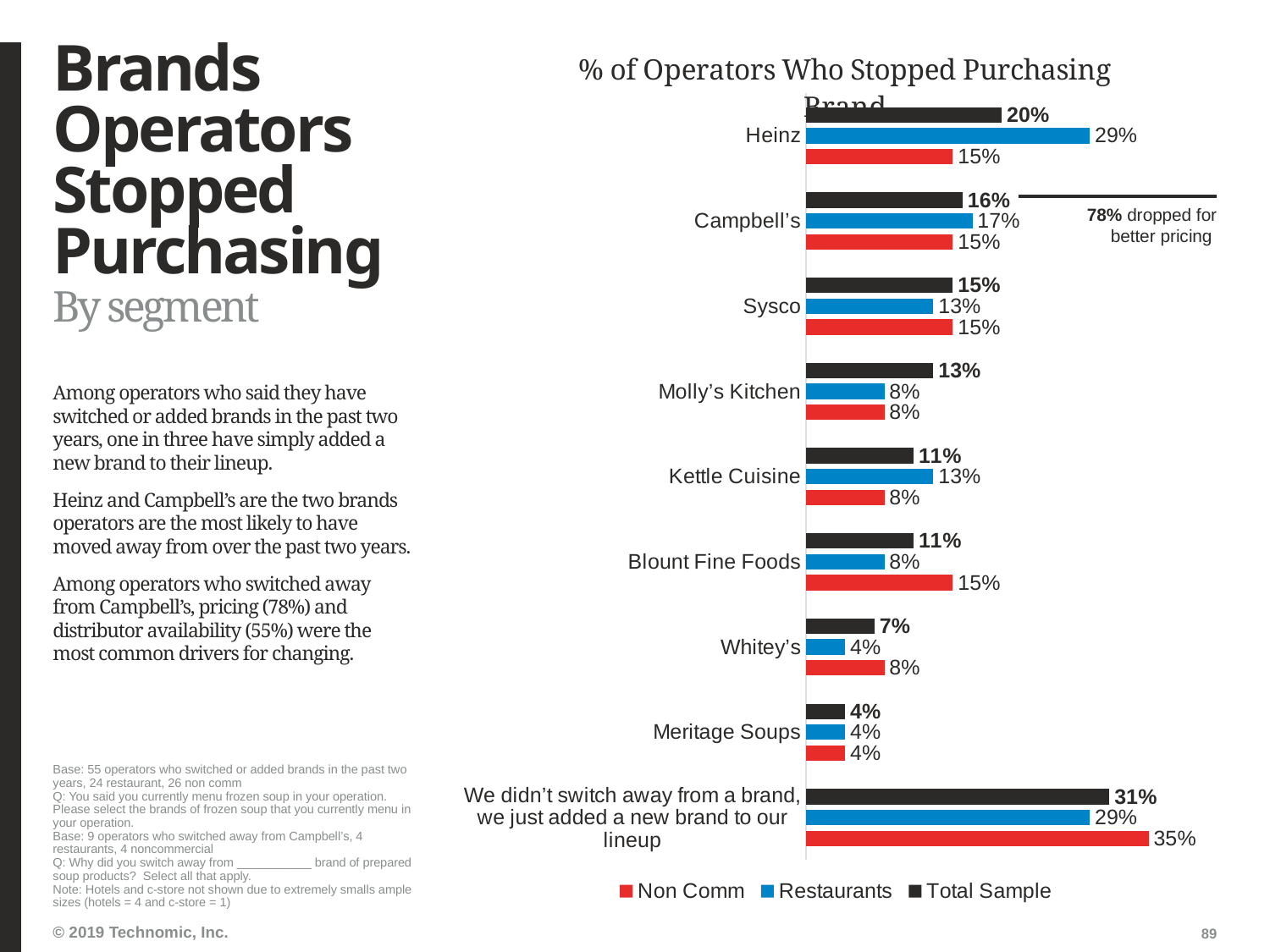
How many series does the chart legend list? 3 What is the difference between the Restaurants and Non Comm values for Heinz? 14% Among the named brands, which has the highest Total Sample value? Heinz What is the Non Comm value for Blount Fine Foods? 15% Which category has the lowest Total Sample value? Meritage Soups What type of chart is shown on the slide? Bar chart Which series is shown in red in the legend? Non Comm What is the Total Sample value for Campbell's? 16% What is the Non Comm value for the category 'We didn't switch away from a brand, we just added a new brand to our lineup'? 35% How many categories are shown on the chart? 9 For Kettle Cuisine, which is larger: the Restaurants value or the Non Comm value? Restaurants What is the Restaurants value for Heinz? 29%